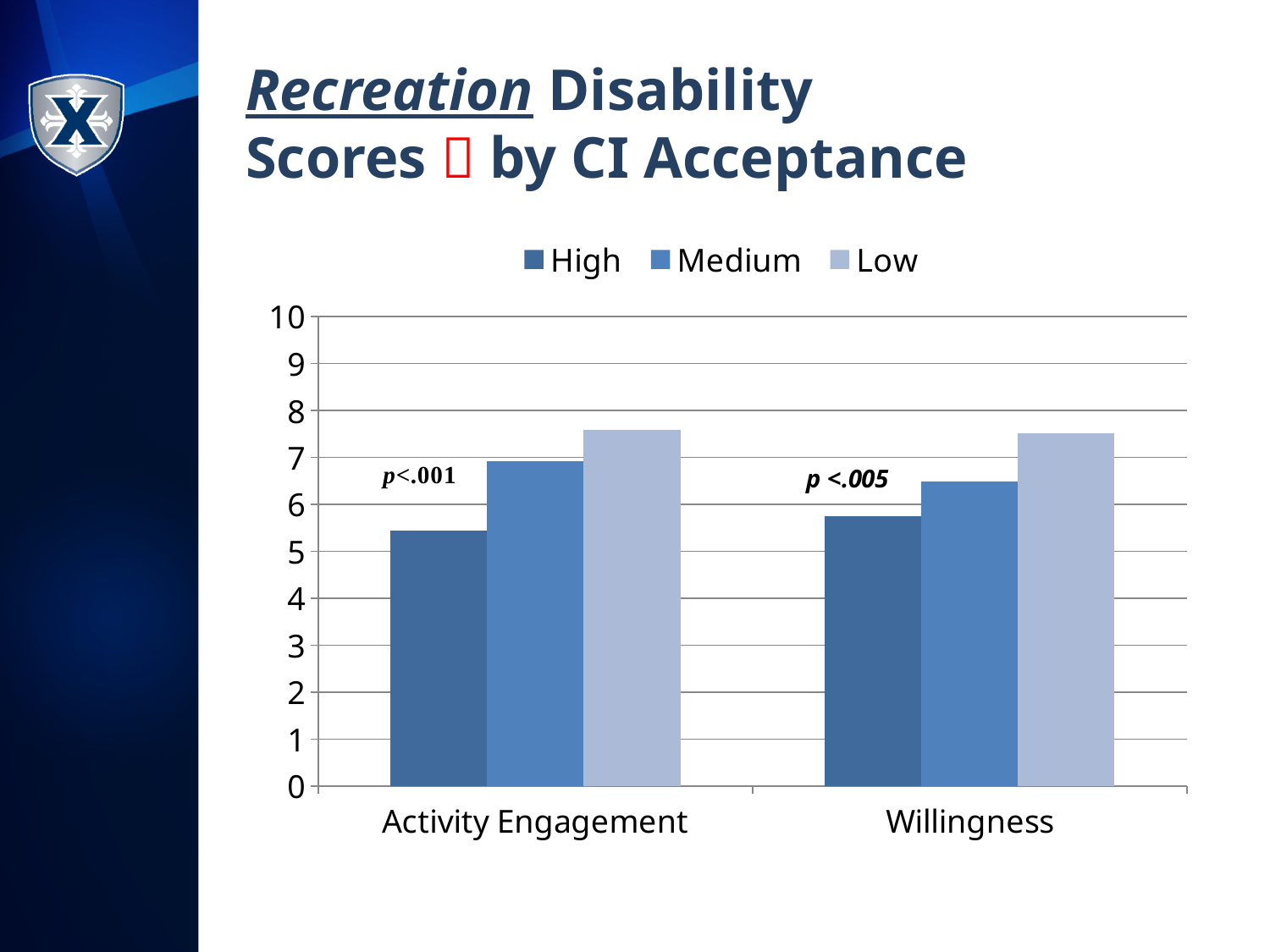
Is the Medium value for Willingness greater or less than 6? greater Is the Low value for Activity Engagement greater or less than 7? greater Which is larger for Activity Engagement, the High value or the Low value? Low How many series does the legend list? 3 Which series has the lowest value for Willingness? High Is the Low value for Willingness greater or less than 7? greater Which is larger, the Medium value for Activity Engagement or the Medium value for Willingness? Activity Engagement How many categories are shown on the x axis? 2 Which series has the highest value for Activity Engagement? Low What p-value is printed above the Activity Engagement bars? p<.001 What kind of chart is shown on the slide? bar chart